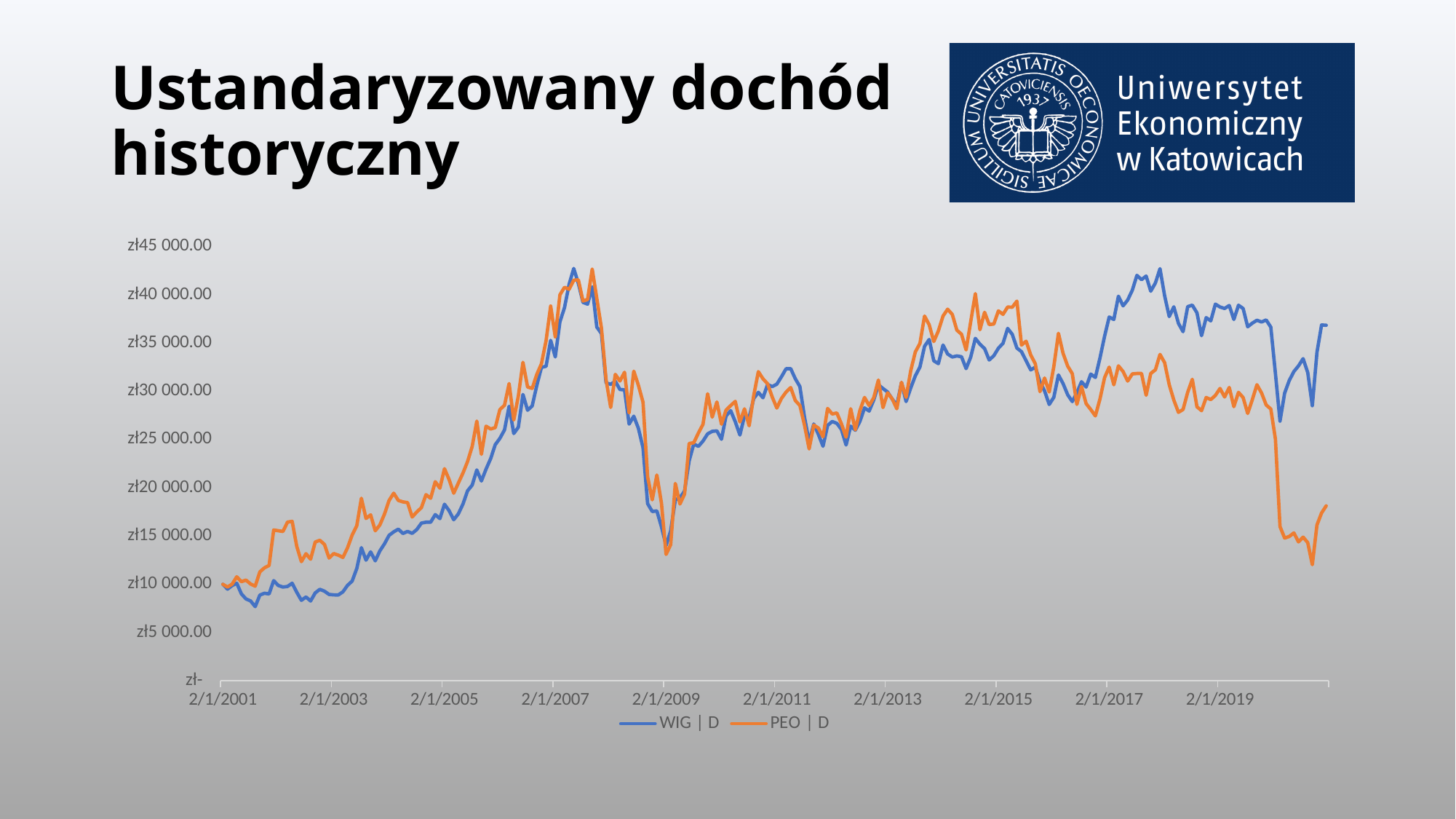
Is the value of PEO | D at the right end of the chart greater or less than zł20 000.00? less At the right end of the chart (the latest date), which series is higher, WIG | D or PEO | D? WIG | D Is the value of WIG | D at the right end of the chart greater or less than zł30 000.00? greater How many series does the legend list? 2 Around 2/1/2003, which series is higher, WIG | D or PEO | D? PEO | D Is the lowest value of PEO | D after 2/1/2019 greater or less than zł15 000.00? less Between the 2007 peak and 2/1/2009, do the PEO | D values rise or fall? fall Between 2/1/2001 and 2/1/2007, do the WIG | D values generally rise or fall? rise What kind of chart is shown on the slide? line chart What are the two series named in the legend? WIG | D and PEO | D What is the title of the slide containing the chart? Ustandaryzowany dochód historyczny